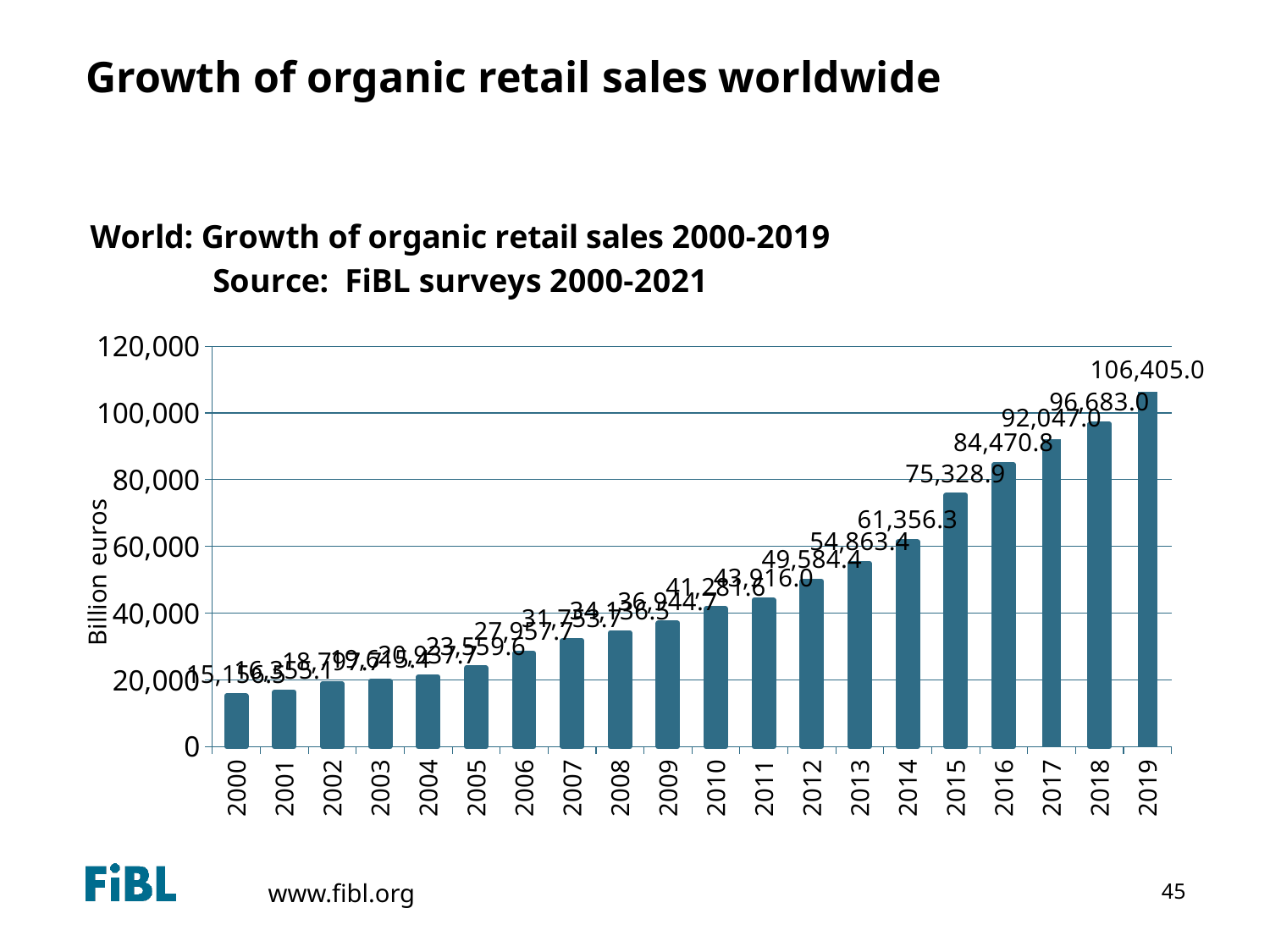
What is the value for 2013? 54,863.4 Which is larger, the value for 2014 or the value for 2012? 2014 What type of chart is shown on the slide? bar chart How many years are shown on the x axis? 20 What is the difference between the values for 2019 and 2018? 9,722.0 Which year has the lowest value? 2000 Which year has the highest value? 2019 What is the value for 2019? 106,405.0 Is the value for 2005 greater or less than 40,000? less What is the value for 2018? 96,683.0 What is the value for 2015? 75,328.9 What is the difference between the values for 2016 and 2015? 9,141.9